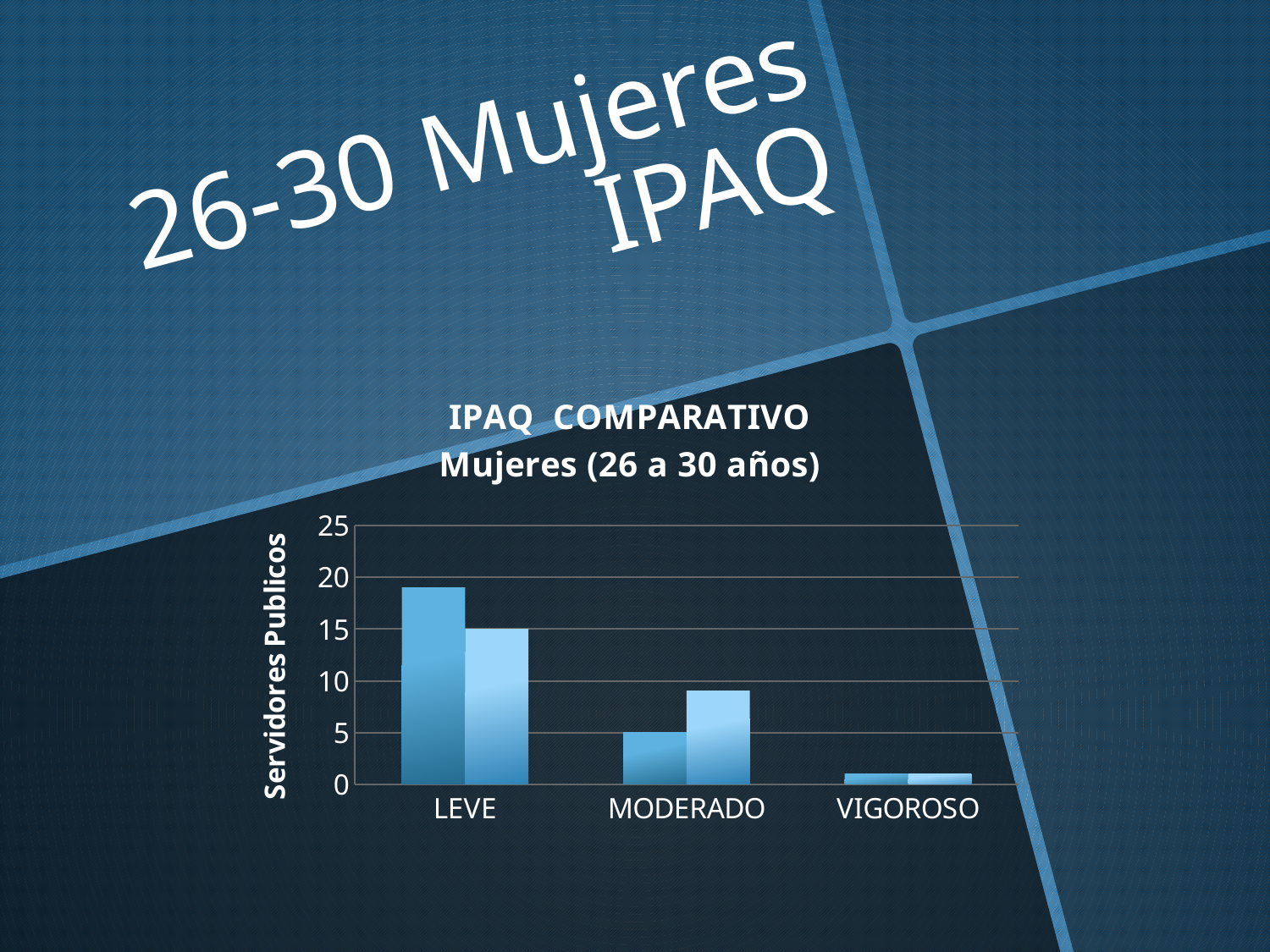
For MODERADO, which bar is taller, the darker one or the lighter one? the lighter one Which is larger: the darker bar for LEVE or the darker bar for MODERADO? LEVE What is the label of the vertical axis of the chart? Servidores Publicos How many categories are shown on the x axis of the chart? 3 Which category has the lowest bars in the chart? VIGOROSO Which category has the tallest bar in the chart? LEVE Is the value of the darker bar for LEVE greater or less than 15? greater What is the title of the chart? IPAQ COMPARATIVO Mujeres (26 a 30 años) Is the value of the lighter bar for MODERADO greater or less than 5? greater What kind of chart is shown on the slide? bar chart Do the values rise or fall moving from LEVE to VIGOROSO along the x axis? fall Are the values for VIGOROSO greater or less than 5? less